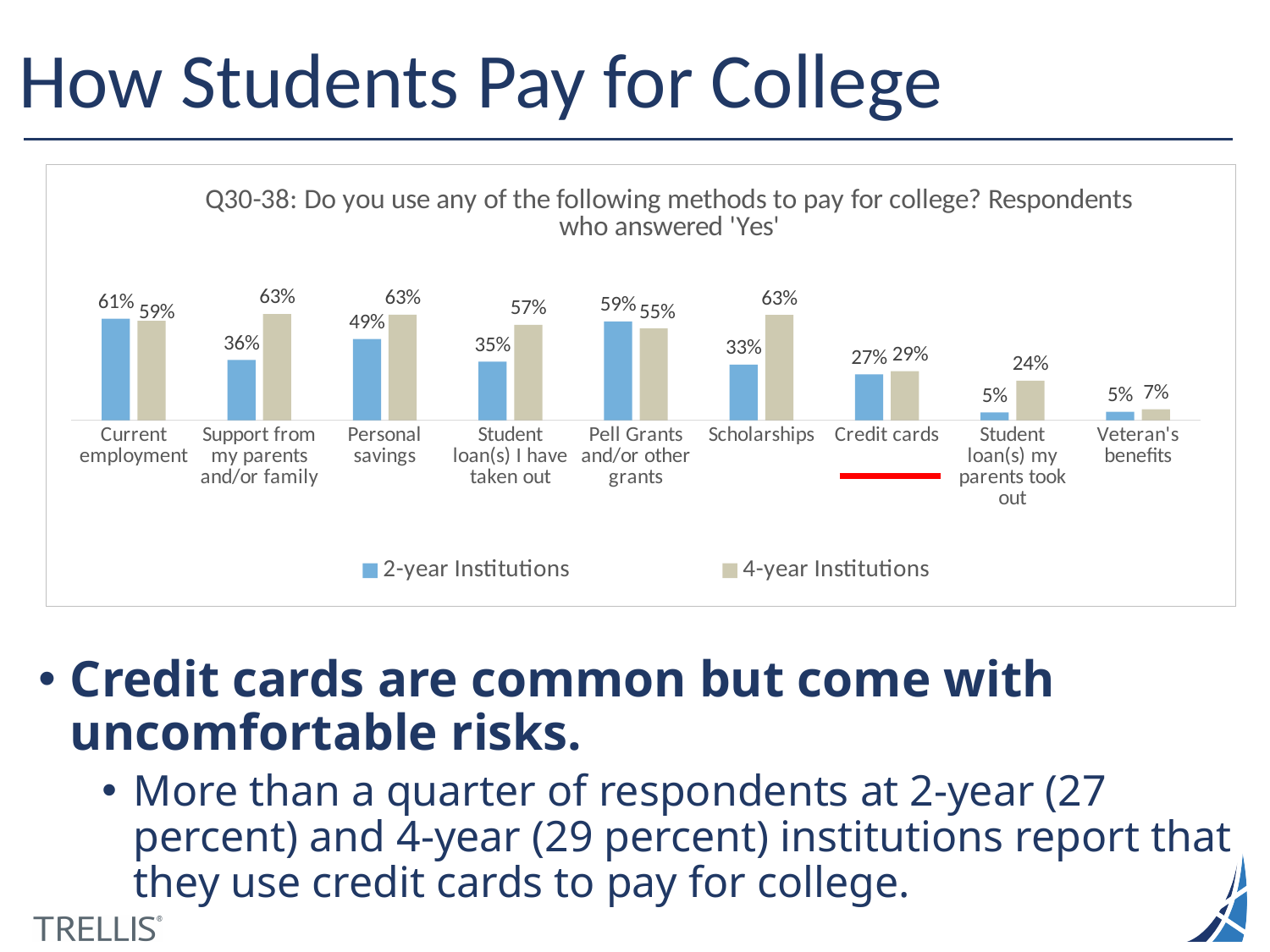
Which series is shown in blue in the legend? 2-year Institutions What percentage of respondents at 2-year institutions use current employment to pay for college? 61% What is the value for credit cards among 4-year institutions? 29% How many payment method categories are shown on the x axis? 9 What percentage of respondents at 4-year institutions use support from my parents and/or family? 63% For Pell Grants and/or other grants, which is larger: the 2-year or the 4-year value? 2-year Institutions How many series does the legend list? 2 What kind of chart is shown on the slide? Bar chart Which category has the lowest value for 4-year institutions? Veteran's benefits Which category has the highest value for 2-year institutions? Current employment What is the difference between the 4-year and 2-year values for student loan(s) my parents took out? 19% For personal savings, which is larger: the 2-year institutions value or the 4-year institutions value? 4-year Institutions